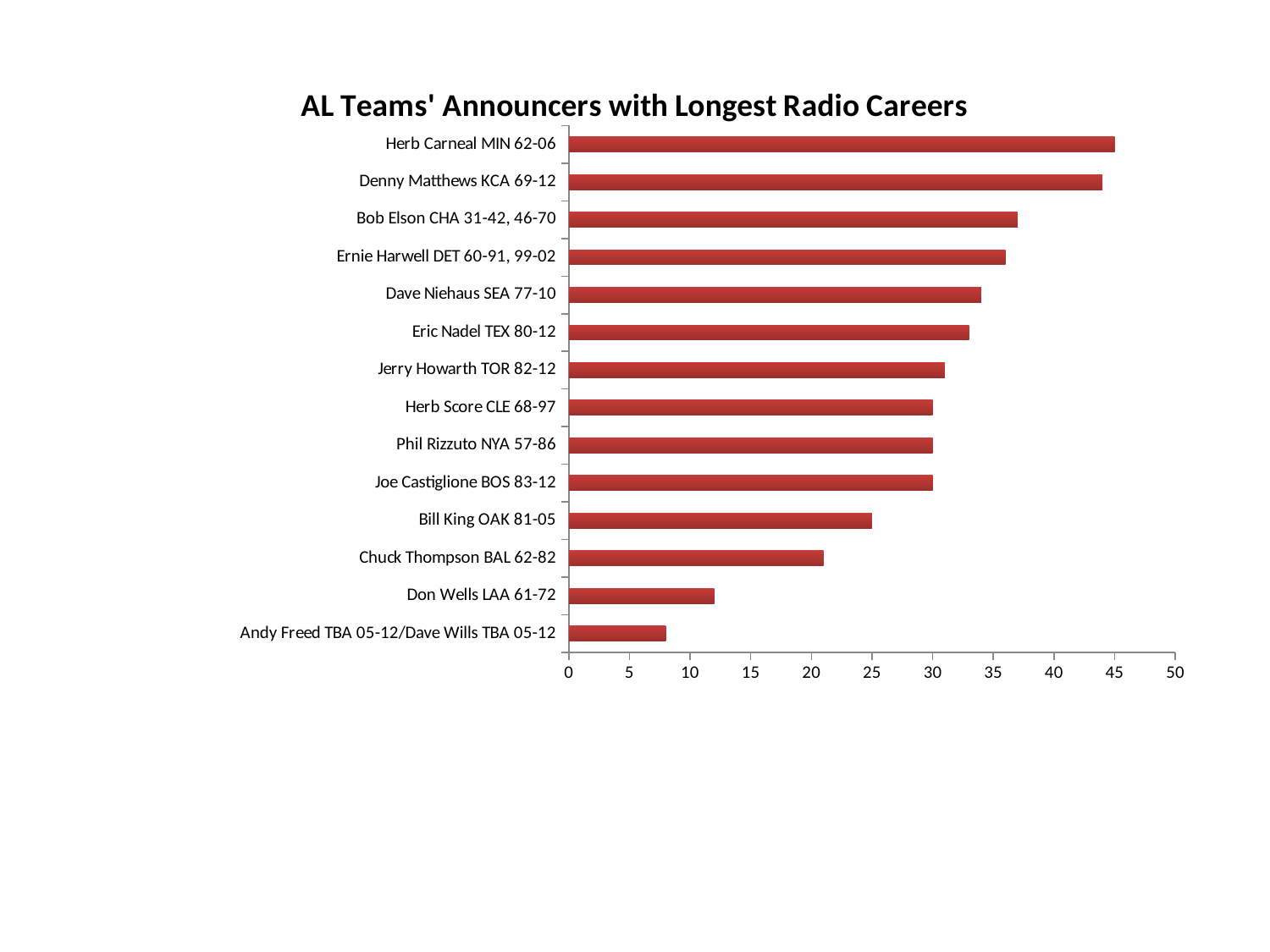
What kind of chart is shown on the slide? bar chart Which announcer has the longest radio career in the chart? Herb Carneal MIN 62-06 How many announcers (categories) are plotted in the chart? 14 Is the value for Denny Matthews KCA 69-12 greater or less than 40? greater Do the bar values increase or decrease going from the top of the chart to the bottom? decrease Is the value for Eric Nadel TEX 80-12 greater or less than 35? less Is the value for Don Wells LAA 61-72 greater or less than 10? greater Which is larger, the value for Bob Elson CHA 31-42, 46-70 or the value for Dave Niehaus SEA 77-10? Bob Elson CHA 31-42, 46-70 Which category has the shortest bar in the chart? Andy Freed TBA 05-12/Dave Wills TBA 05-12 Which is larger, the value for Bill King OAK 81-05 or the value for Jerry Howarth TOR 82-12? Jerry Howarth TOR 82-12 What is the title of the chart? AL Teams' Announcers with Longest Radio Careers